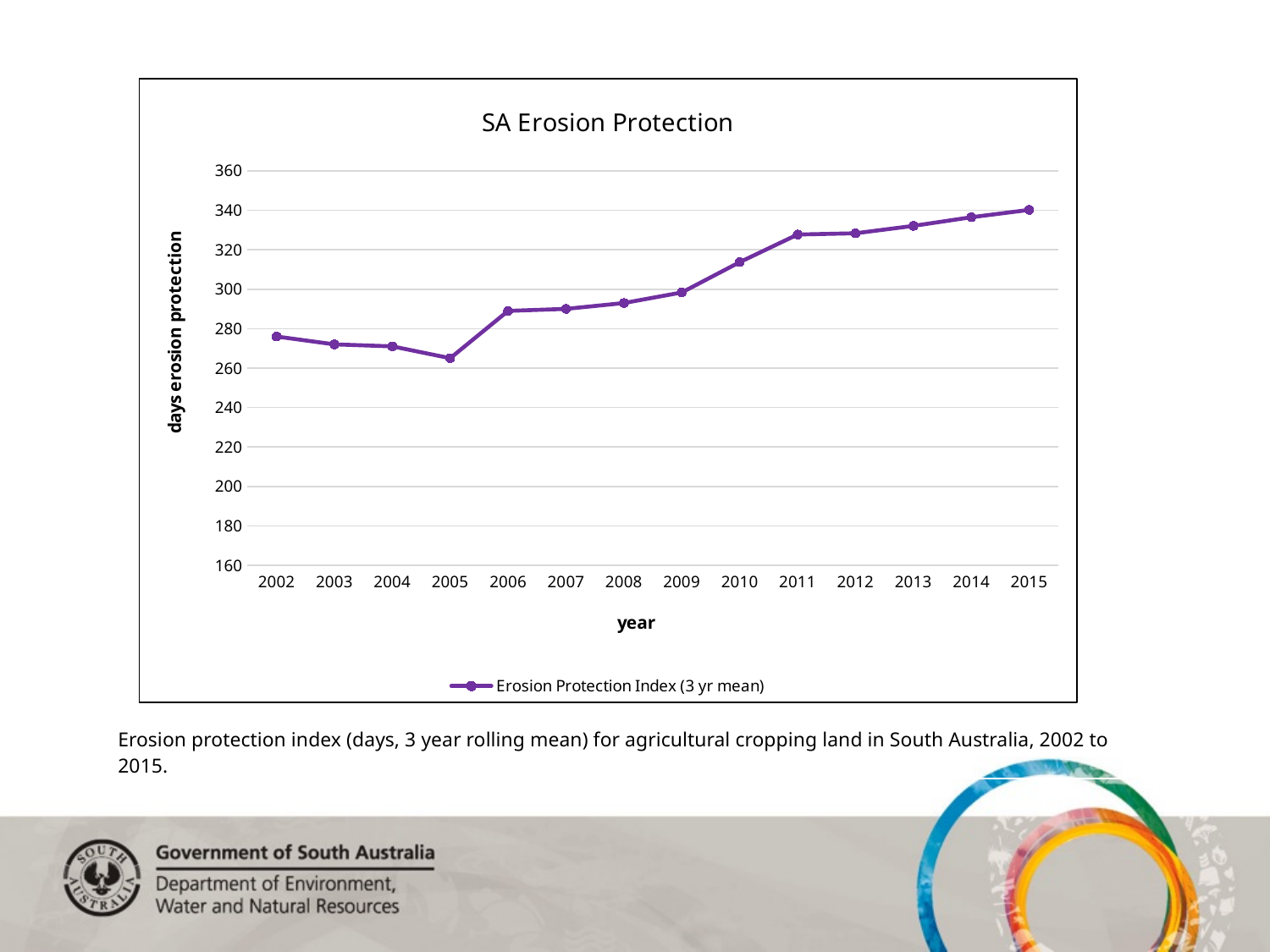
What is the title of the chart? SA Erosion Protection Which year has the highest erosion protection index value? 2015 Is the value for 2015 greater or less than 320? greater Is the value for 2002 greater or less than 300? less How many series does the legend list? 1 Which year has the larger value, 2005 or 2010? 2010 Is the value for 2005 greater or less than 280? less Which year has the lowest erosion protection index value? 2005 How many years are plotted on the x axis? 14 What kind of chart is shown on the slide? line chart Overall, does the erosion protection index rise or fall from 2002 to 2015? rise